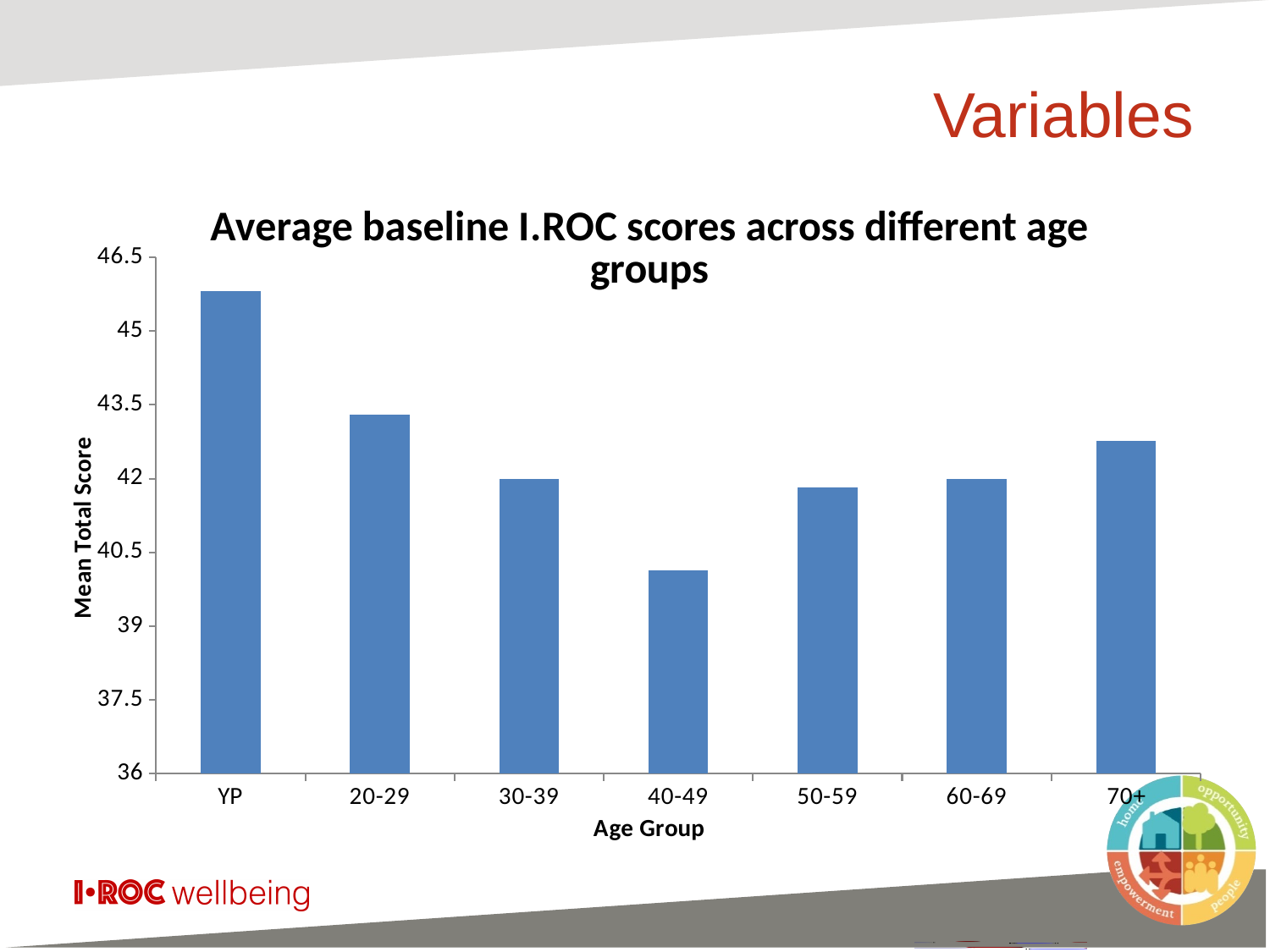
Which age group has the lowest mean total score? 40-49 What kind of chart is shown on the slide? bar chart Is the mean total score for the 70+ age group greater or less than 42? greater Which has a higher mean total score, the 20-29 age group or the 70+ age group? 20-29 Is the mean total score for YP greater or less than 45? greater Which age group has the highest mean total score? YP Is the mean total score for the 20-29 age group greater or less than 43.5? less How many age groups are shown on the x axis of the chart? 7 What is the title of the chart? Average baseline I.ROC scores across different age groups Do the mean total scores rise or fall from the 20-29 group to the 40-49 group? fall What is the label on the y axis of the chart? Mean Total Score